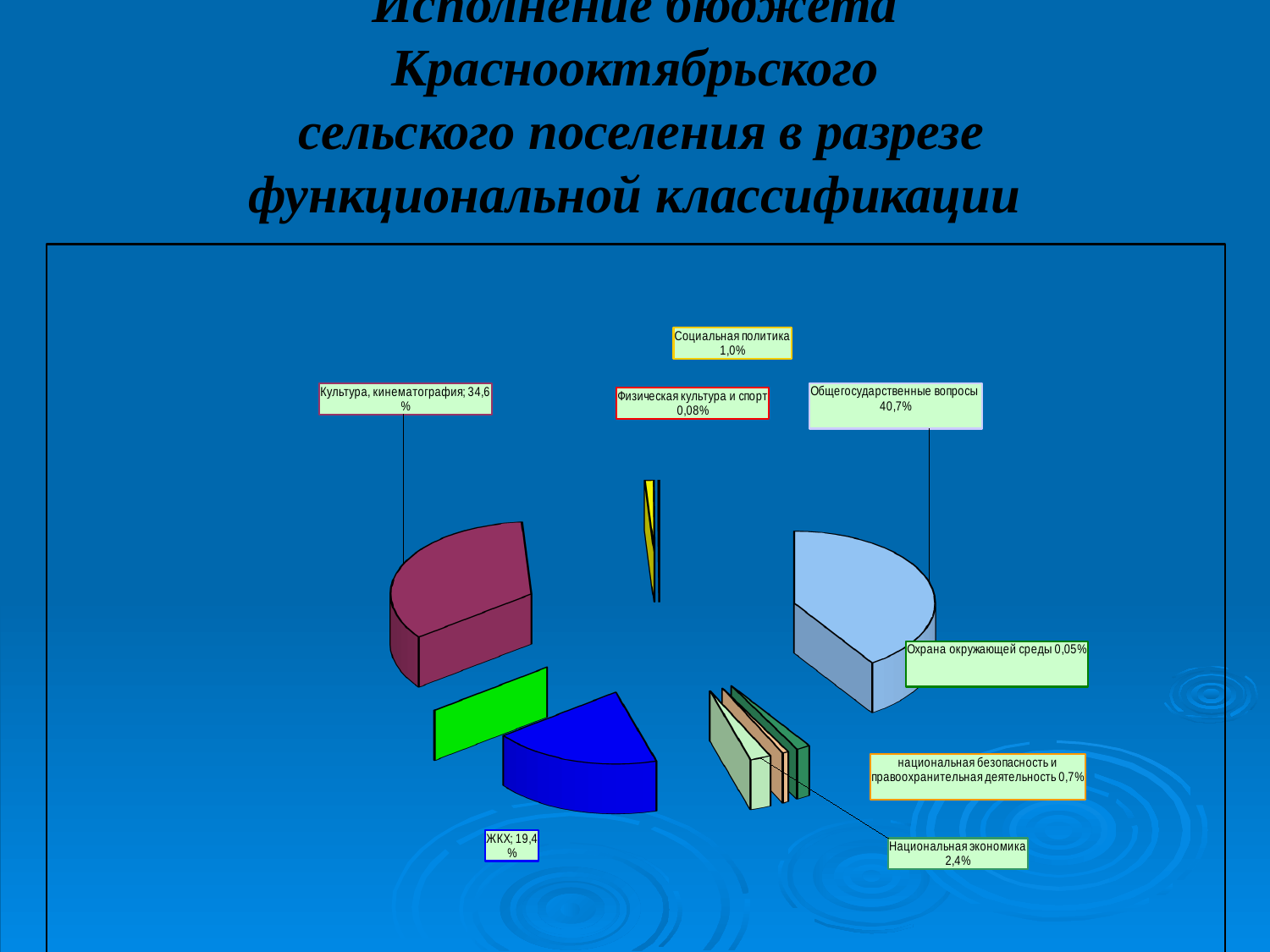
What type of chart is shown on the slide? pie chart Which is larger: the share for ЖКХ or the share for Национальная экономика? ЖКХ Which category has the smallest share of the pie? Охрана окружающей среды What share is shown for Культура, кинематография? 34,6% What share is shown for Национальная экономика? 2,4% What is the value for Физическая культура и спорт? 0,08% What share is shown for Социальная политика? 1,0% What share of the budget goes to Общегосударственные вопросы? 40,7% What is the value for ЖКХ? 19,4% Which category has the largest share of the pie? Общегосударственные вопросы What is the difference between the shares of Общегосударственные вопросы and Культура, кинематография? 6,1%